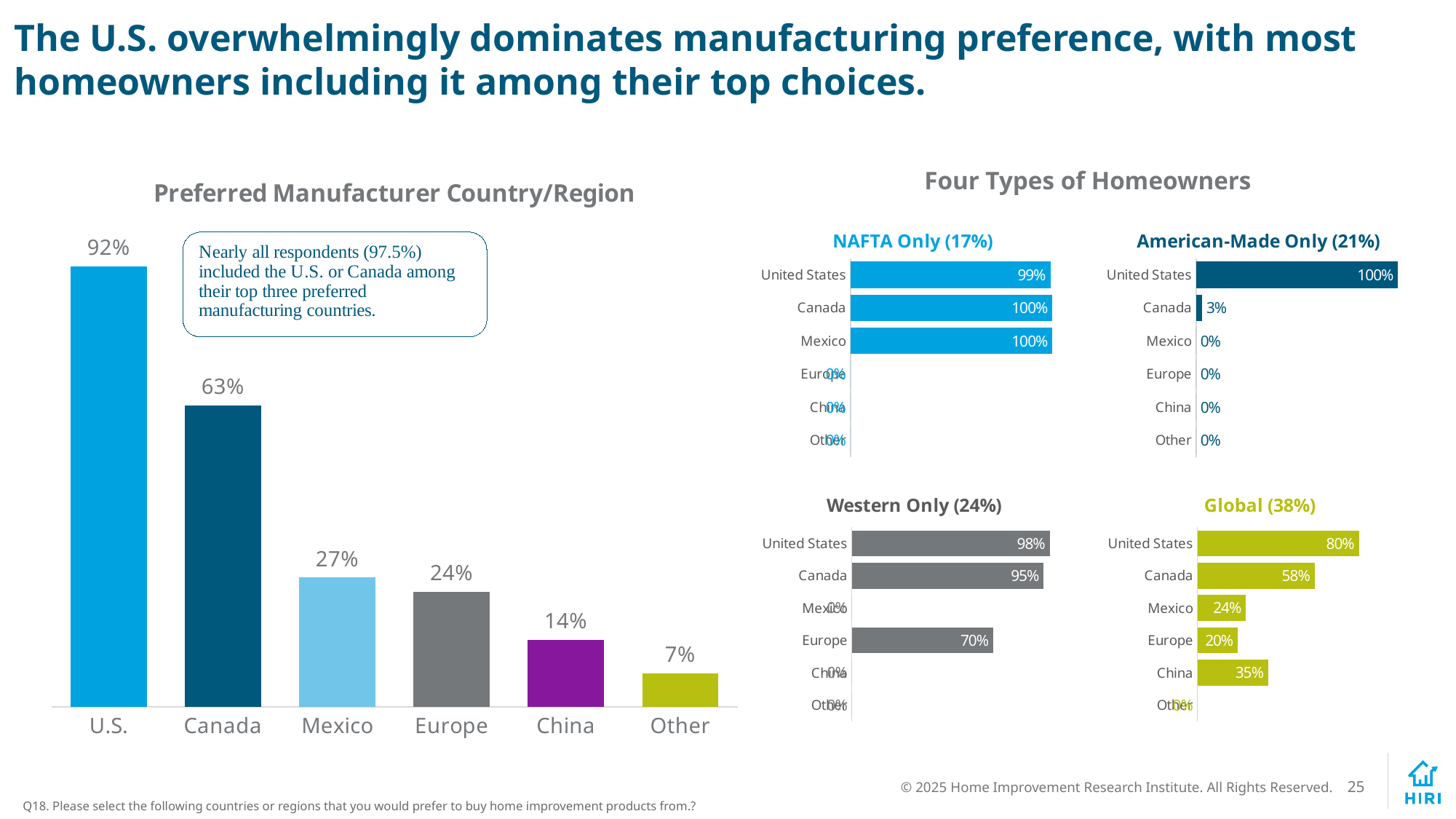
In the 'Western Only (24%)' chart, what is the value for Europe? 70% In the 'Preferred Manufacturer Country/Region' chart, do the values rise or fall from left to right? Fall In the 'Global (38%)' chart, which is larger, the value for Mexico or the value for China? China In the 'Preferred Manufacturer Country/Region' chart, which category has the highest value? U.S. In the 'Preferred Manufacturer Country/Region' chart, what is the difference between the values for U.S. and Canada? 29% In the 'American-Made Only (21%)' chart, what is the value for Canada? 3% In the 'Preferred Manufacturer Country/Region' chart, how many categories are shown? 6 In the 'NAFTA Only (17%)' chart, what is the value for United States? 99% What kind of chart is the 'Preferred Manufacturer Country/Region' chart? Bar chart In the 'Preferred Manufacturer Country/Region' chart, what is the value for Canada? 63% In the 'Preferred Manufacturer Country/Region' chart, which category has the lowest value? Other In the 'Global (38%)' chart, what is the value for China? 35%